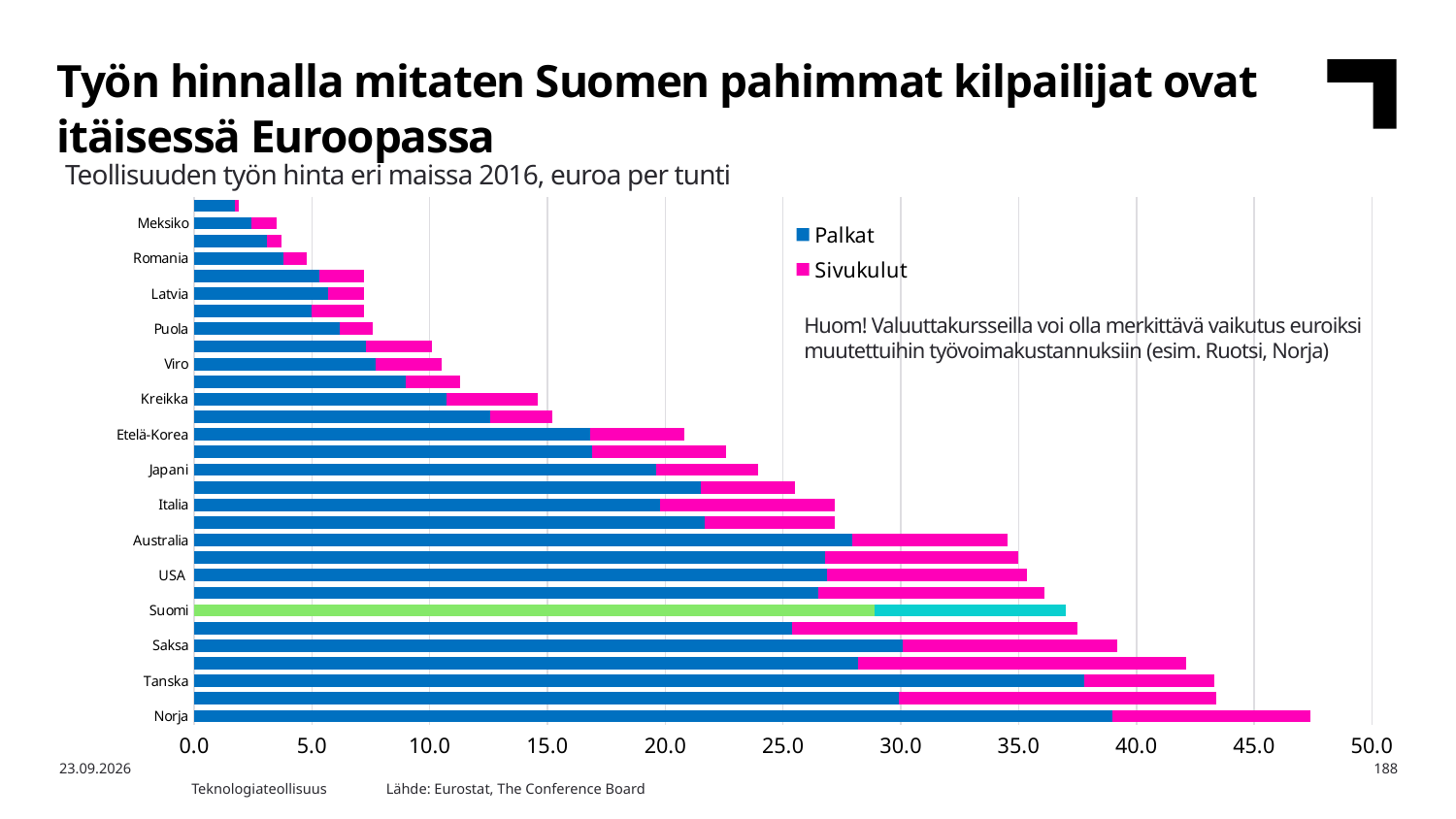
Which country's bar is highlighted in green? Suomi Is the total bar for Meksiko greater or less than 5.0? less Which has the longer total bar, Norja or Tanska? Norja What kind of chart is shown on the slide? Stacked bar chart Is the total bar for Puola greater or less than 10.0? less Is the total bar for Suomi greater or less than 35.0? greater How many series does the legend list? 2 Do the total bar lengths increase or decrease from the top of the chart to the bottom? increase Which has the longer total bar, Japani or Etelä-Korea? Japani What are the two series named in the legend? Palkat and Sivukulut Which labelled country has the longest total bar? Norja